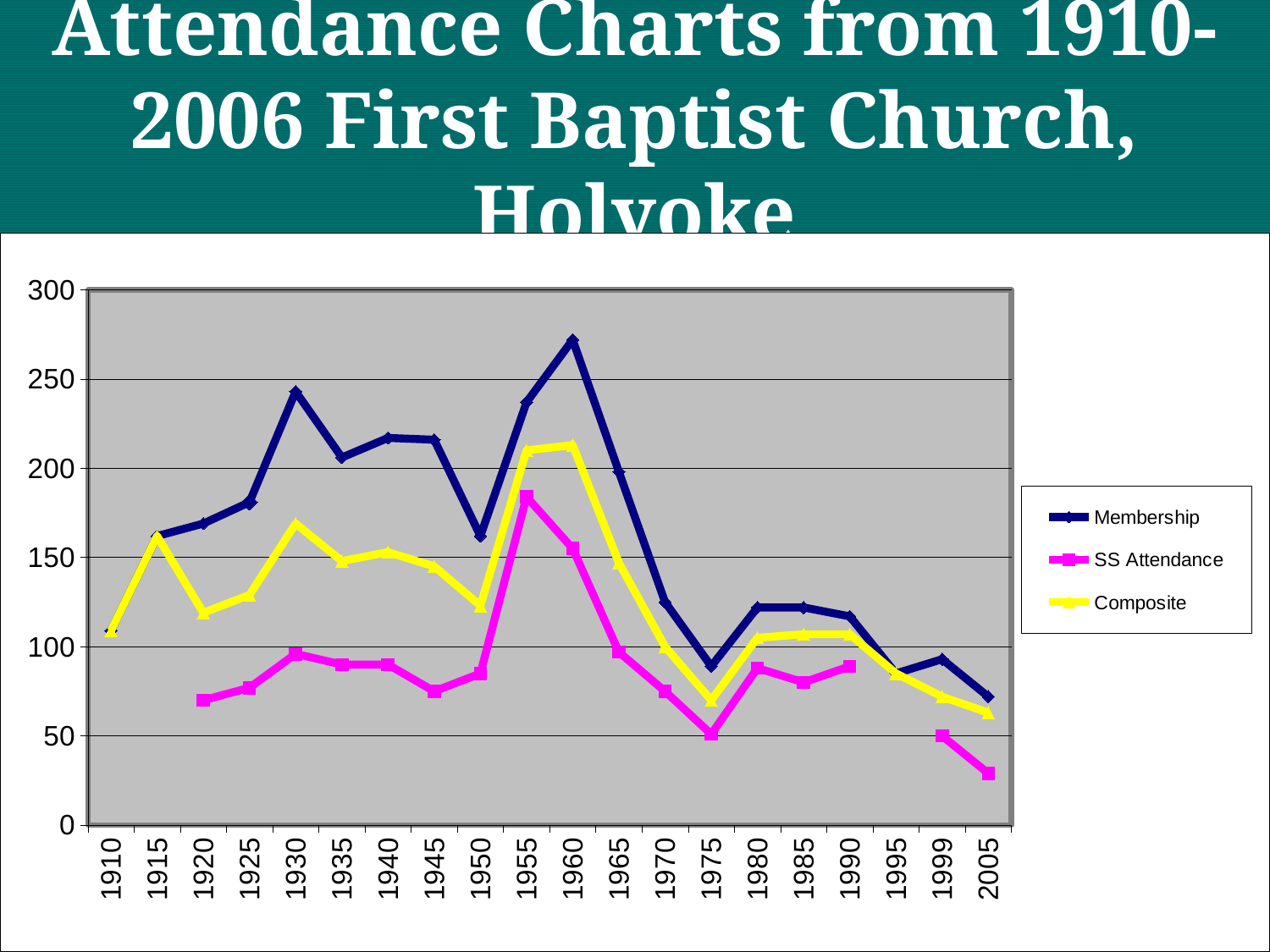
In which year does the Membership series reach its highest value? 1960 How many series does the legend list? 3 Does the Membership series rise or fall between 1960 and 1975? Fall Is the Membership value for 1930 greater or less than 200? greater In which year does the SS Attendance series reach its highest value? 1955 In which year is the Membership series at its lowest? 2005 Is the Membership value for 1960 greater or less than 250? greater How many years are shown along the x axis? 20 In which year is the SS Attendance series at its lowest? 2005 In 1955, which is larger: Membership or SS Attendance? Membership Is the SS Attendance value for 2005 greater or less than 50? less What kind of chart is shown on the slide? Line chart